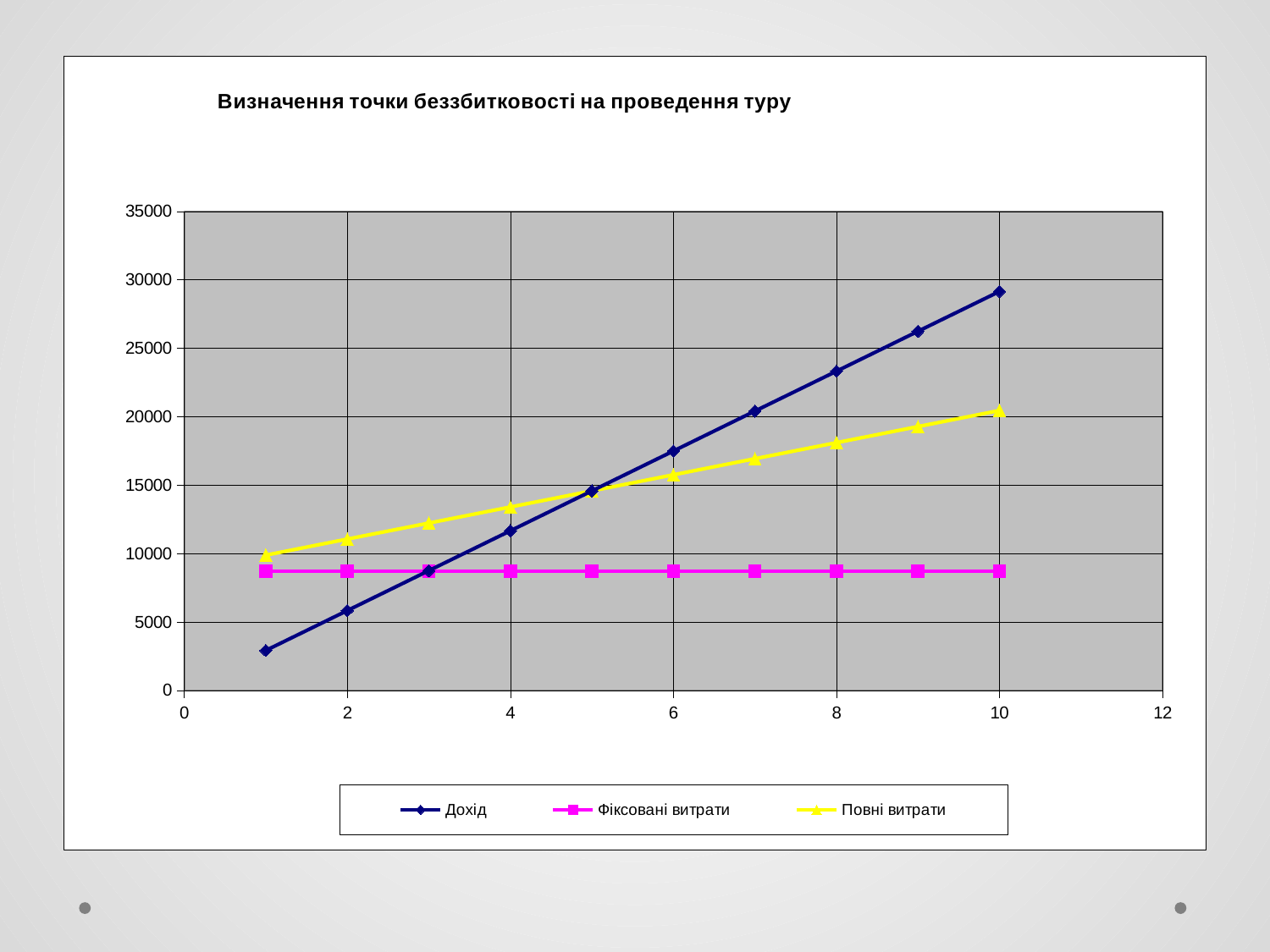
Is the value of Дохід at x = 10 greater or less than 25000? greater Does the Фіксовані витрати series rise, fall or stay flat along the x axis? stay flat How many data points does the Дохід series have? 10 Is the value of Повні витрати at x = 10 greater or less than 15000? greater How many series does the legend list? 3 Does the Дохід series rise or fall as the x value increases from 1 to 10? rise Is the value of Фіксовані витрати greater or less than 10000? less At x = 2, which is larger: Дохід or Повні витрати? Повні витрати What kind of chart is shown on the slide? line chart At x = 10, which is larger: Дохід or Повні витрати? Дохід What is the title of the chart? Визначення точки беззбитковості на проведення туру